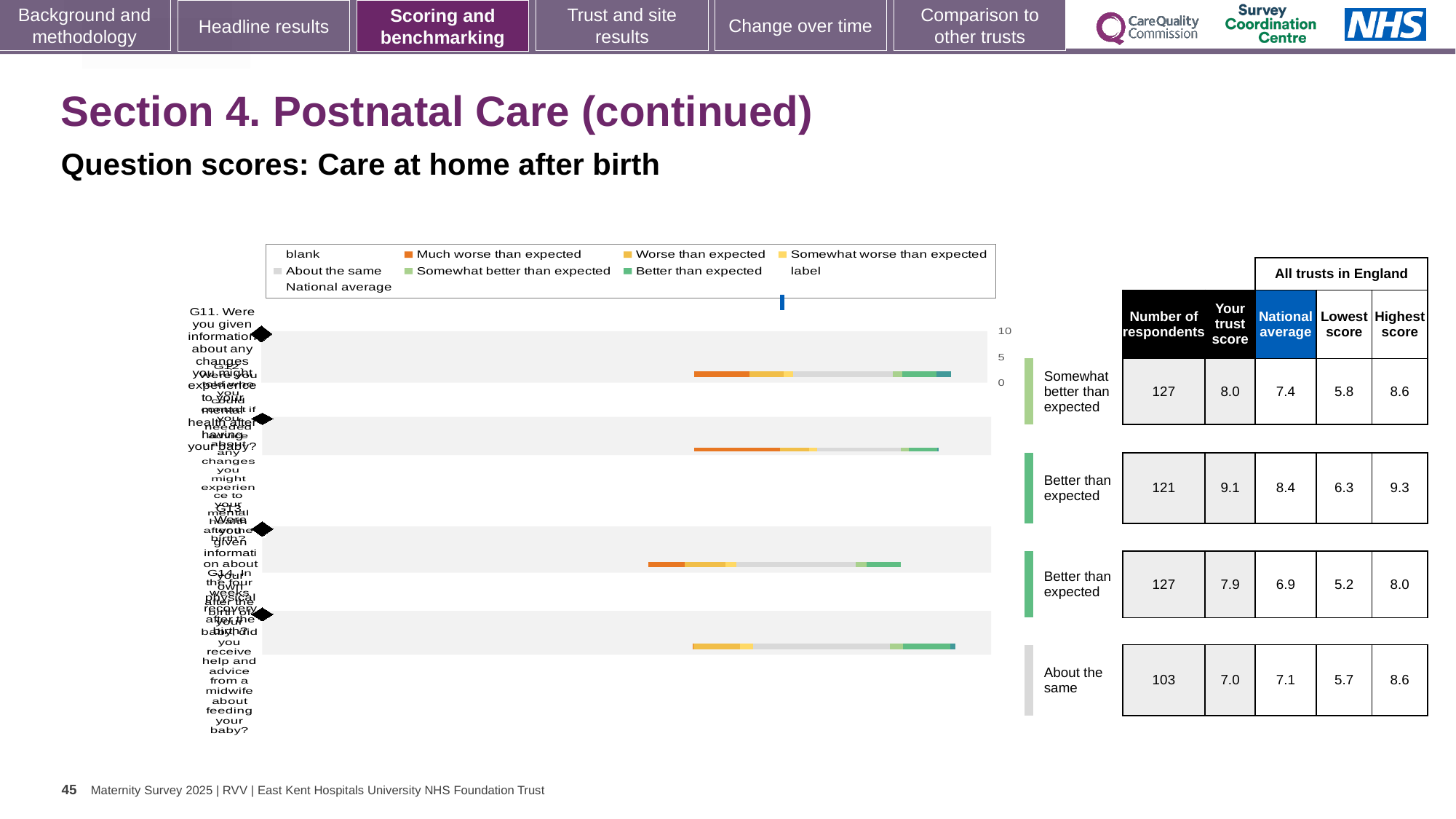
In the table to the right of the chart, what is the number of respondents for the row labelled 'About the same'? 103 What is the highest tick value shown on the chart's axis? 10 What kind of chart is shown on the slide? bar chart How many entries does the chart legend list? 9 In the table to the right of the chart, what is the 'Your trust score' for the row labelled 'About the same'? 7.0 In the table to the right of the chart, what is the national average for the row labelled 'Somewhat better than expected'? 7.4 How many horizontal bars are plotted in the chart? 4 In the table to the right of the chart, what is the difference between 'Your trust score' and the national average for the row labelled 'Somewhat better than expected'? 0.6 In the table to the right of the chart, which row has the highest 'Your trust score'? Better than expected (121 respondents) What colour represents 'Much worse than expected' in the chart legend? orange